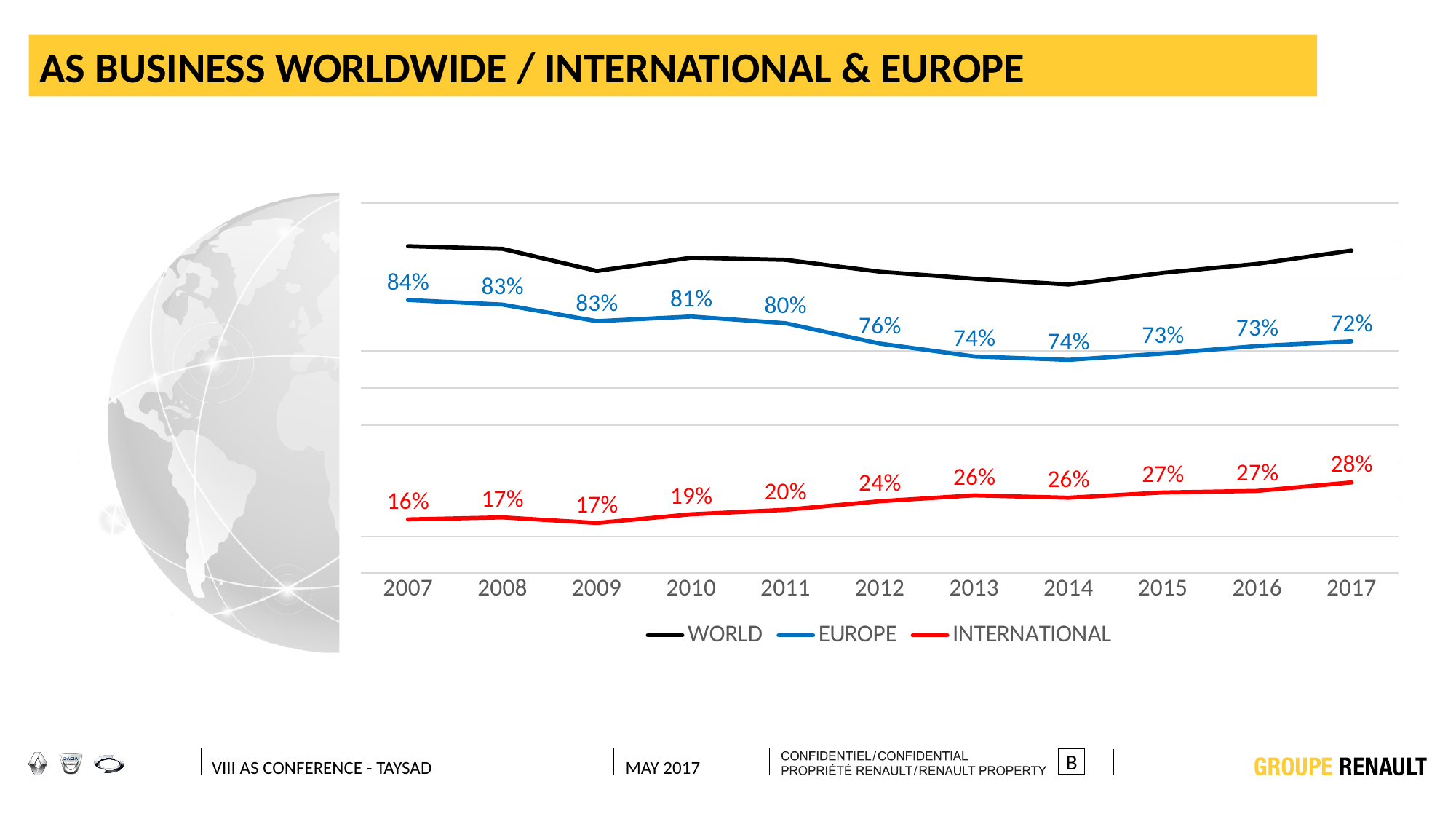
What is the EUROPE value for 2007? 84% Which year has the larger INTERNATIONAL value, 2011 or 2013? 2013 Does the EUROPE series generally rise or fall from 2007 to 2017? Fall How many series does the legend list? 3 How many years are shown on the x axis? 11 What kind of chart is shown on the slide? Line chart By how many percentage points did the EUROPE value fall from 2007 to 2017? 12 percentage points What is the INTERNATIONAL value for 2017? 28% What is the EUROPE value for 2012? 76% Does the INTERNATIONAL series generally rise or fall from 2007 to 2017? Rise In which year is the INTERNATIONAL series at its highest? 2017